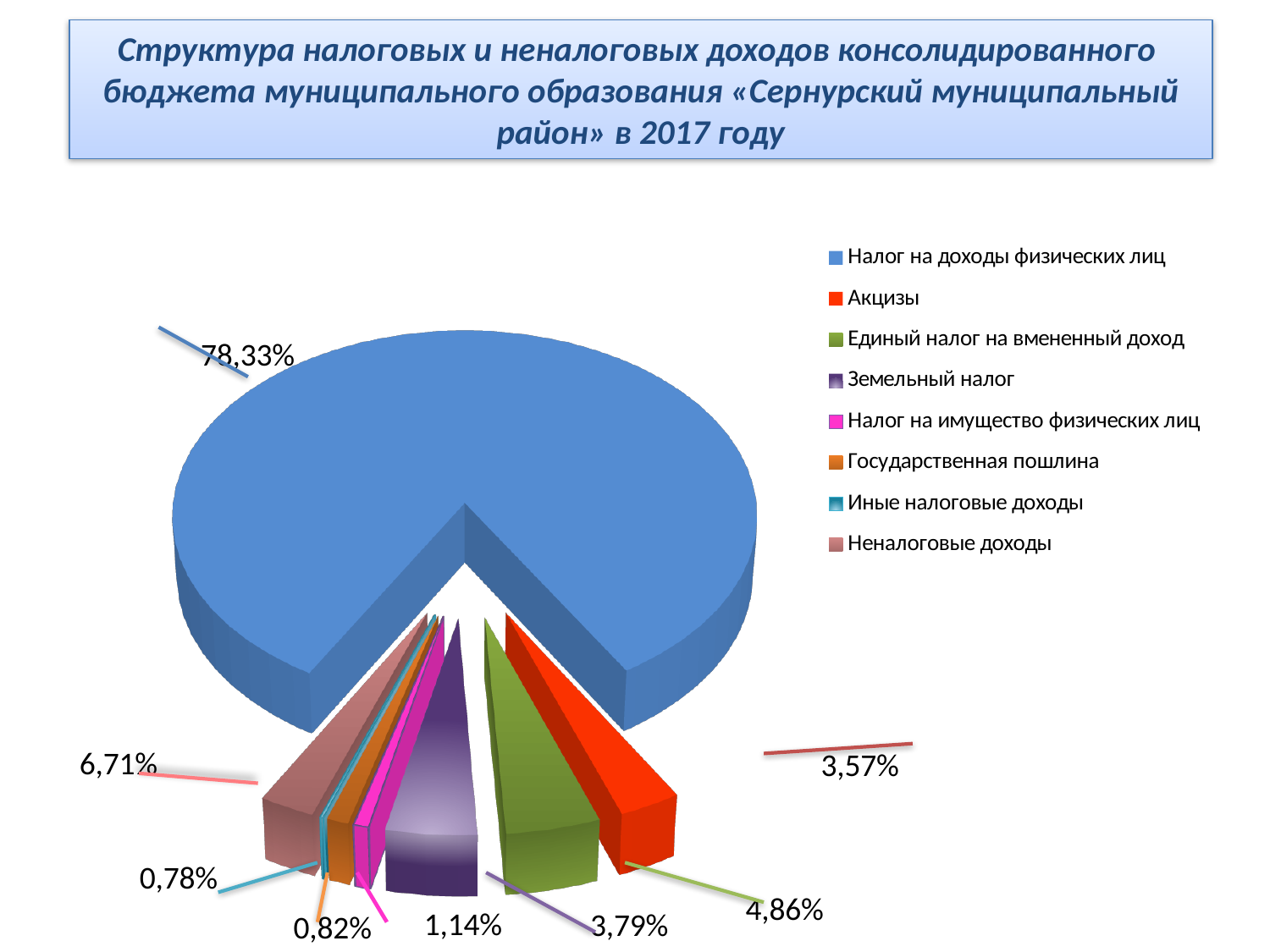
What is the difference between the values for Неналоговые доходы and Единый налог на вмененный доход? 1,85% Which category has the largest slice of the pie? Налог на доходы физических лиц What is the value shown for Единый налог на вмененный доход? 4,86% What share of the pie does Налог на доходы физических лиц have? 78,33% What is the value shown for Акцизы? 3,57% How many categories does the legend list? 8 What is the value shown for Неналоговые доходы? 6,71% Which category has the smallest slice of the pie? Иные налоговые доходы Which is larger, Единый налог на вмененный доход or Акцизы? Единый налог на вмененный доход Which colour represents Государственная пошлина in the chart? orange What kind of chart is shown on the slide? pie chart What is the value shown for Земельный налог? 3,79%